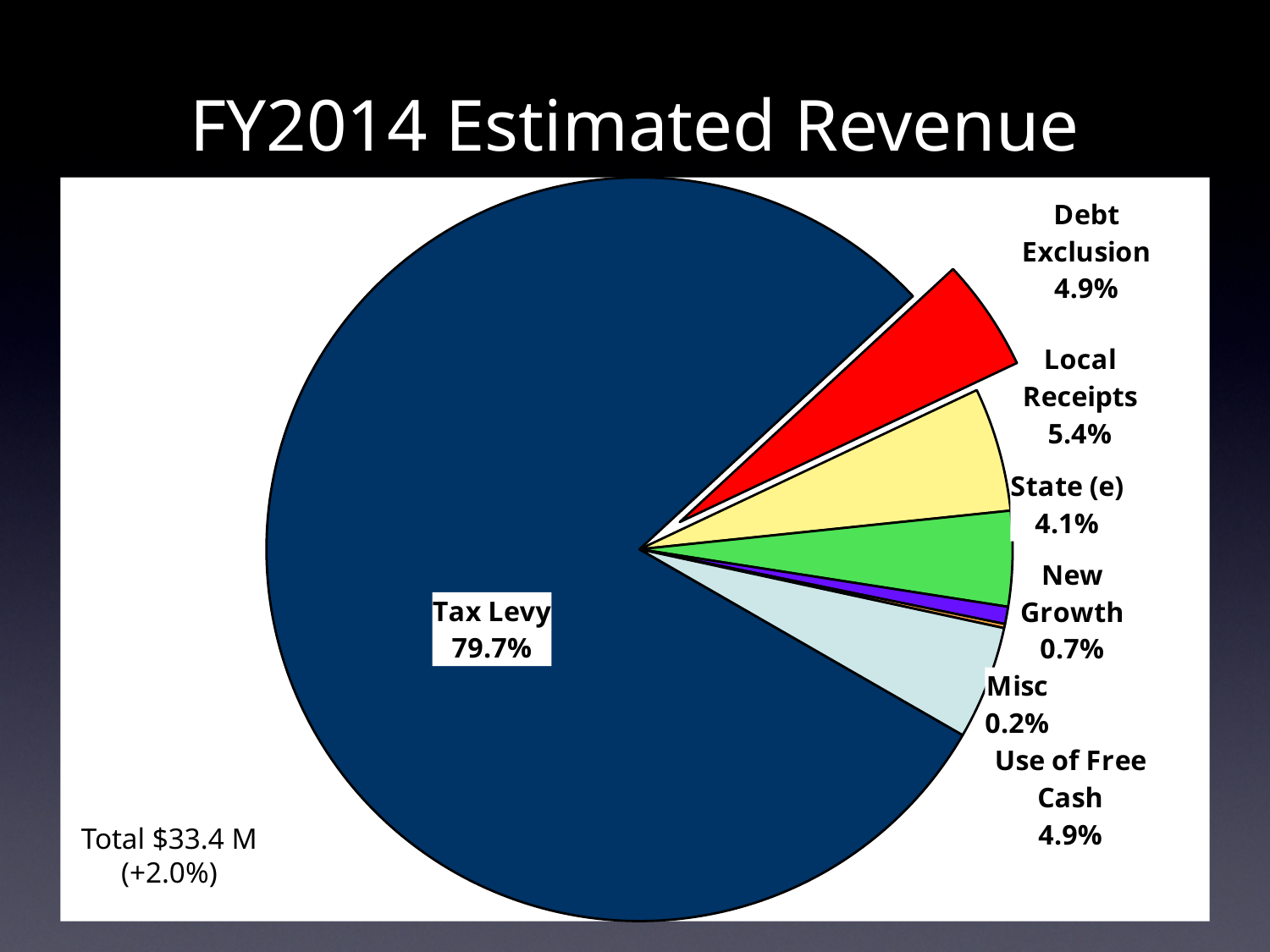
What is the difference in percentage points between Local Receipts and State (e)? 1.3 Which category has the smallest slice of the pie? Misc What is the title of the chart? FY2014 Estimated Revenue What share of the pie does Tax Levy represent? 79.7% What kind of chart is shown on the slide? Pie chart What total revenue amount is noted on the chart? $33.4 M Which is larger, Local Receipts or Debt Exclusion? Local Receipts What percentage is shown for New Growth? 0.7% What percentage is shown for Local Receipts? 5.4% What percentage is shown for State (e)? 4.1% How many categories are shown in the pie chart? 7 Which category has the largest slice of the pie? Tax Levy